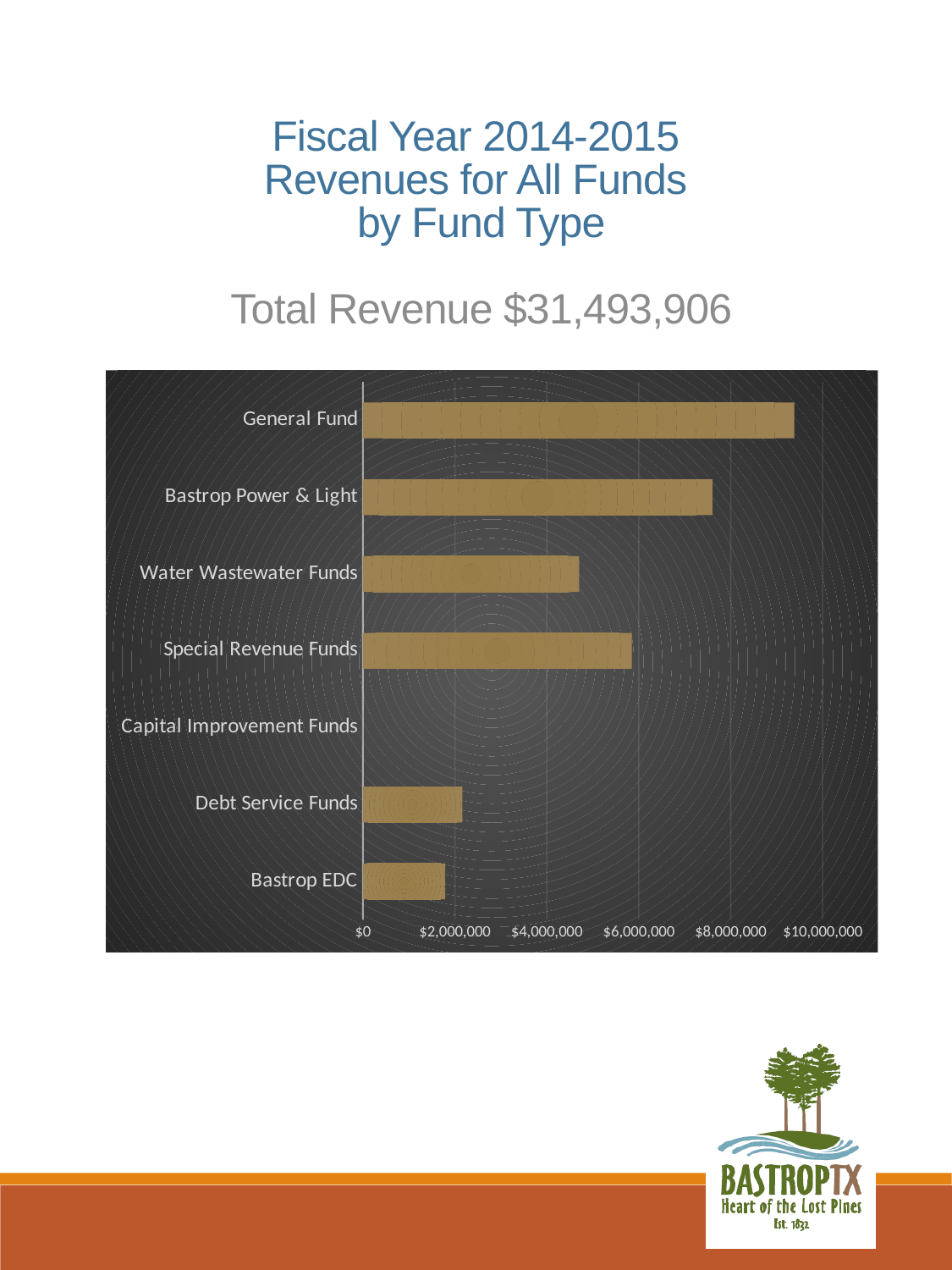
Is the value for General Fund greater or less than $8,000,000? greater Is the value for Water Wastewater Funds greater or less than $4,000,000? greater Is the value for Debt Service Funds greater or less than $4,000,000? less How many fund types are shown in the chart? 7 What total revenue figure is stated on the slide? $31,493,906 Which fund type has the lowest revenue in the chart? Capital Improvement Funds What is the title of the slide containing the chart? Fiscal Year 2014-2015 Revenues for All Funds by Fund Type What kind of chart is shown on the slide? Bar chart Which is larger, the revenue for Special Revenue Funds or for Water Wastewater Funds? Special Revenue Funds Which is larger, the revenue for General Fund or for Bastrop Power & Light? General Fund Which fund type has the highest revenue in the chart? General Fund